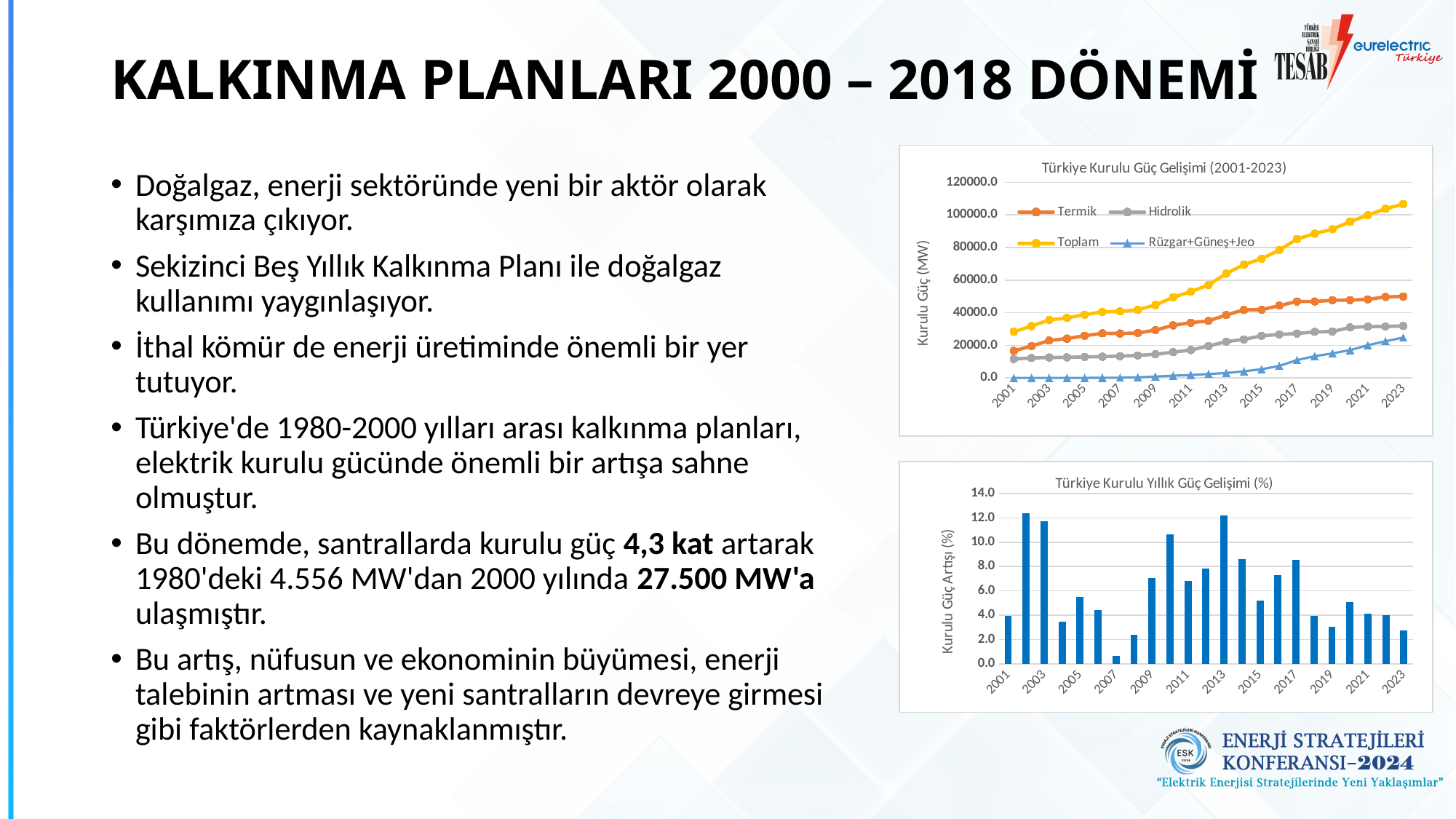
In the top chart, which series has the highest value in 2023? Toplam In the bottom chart, is the value for 2007 greater or less than 2.0? less In the top chart, does the Toplam series rise or fall from 2001 to 2023? rise How many series does the legend of the top chart list? 4 In the bottom chart, which year has the lowest value? 2007 In the bottom chart, which is larger, the value for 2013 or the value for 2014? 2013 In the top chart, is the Hidrolik value for 2023 greater or less than 20000.0? greater What kind of chart is the bottom chart, 'Türkiye Kurulu Yıllık Güç Gelişimi (%)'? bar chart In the top chart, is the Toplam value for 2023 greater or less than 100000.0? greater What kind of chart is the top chart, 'Türkiye Kurulu Güç Gelişimi (2001-2023)'? line chart In the top chart, which series has the lowest value in 2023? Rüzgar+Güneş+Jeo What is the y-axis label of the top chart? Kurulu Güç (MW)